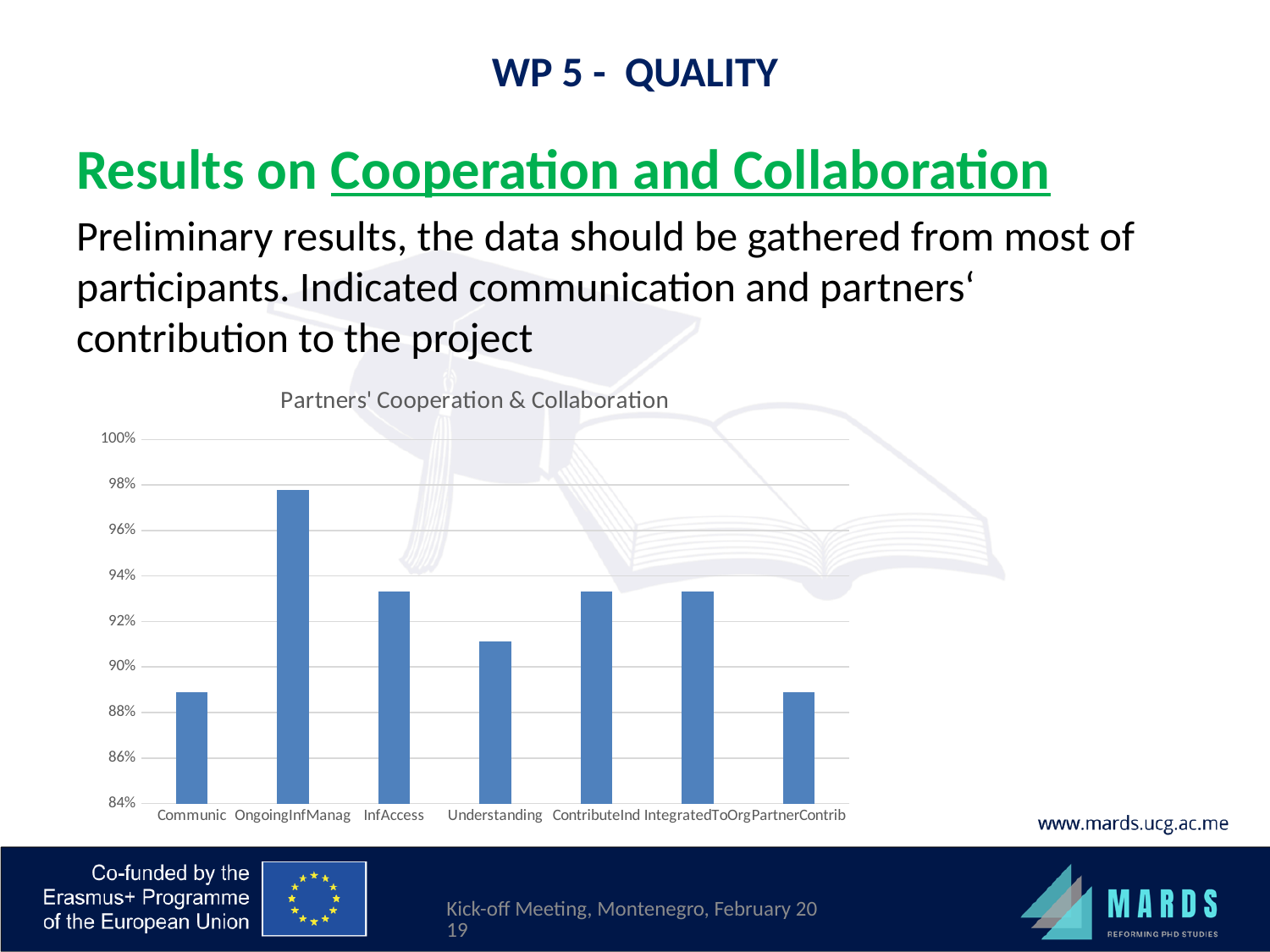
Which is larger, the value for InfAccess or the value for Communic? InfAccess How many categories are plotted in the chart? 7 What type of chart is shown on the slide? bar chart Is the value for PartnerContrib greater or less than 90%? less Is the value for Understanding greater or less than 90%? greater What is the title of the chart? Partners' Cooperation & Collaboration Which category has the highest value in the chart? OngoingInfManag Is the value for OngoingInfManag greater or less than 96%? greater Which is larger, the value for ContributeInd or the value for Understanding? ContributeInd Which is larger, the value for OngoingInfManag or the value for Understanding? OngoingInfManag